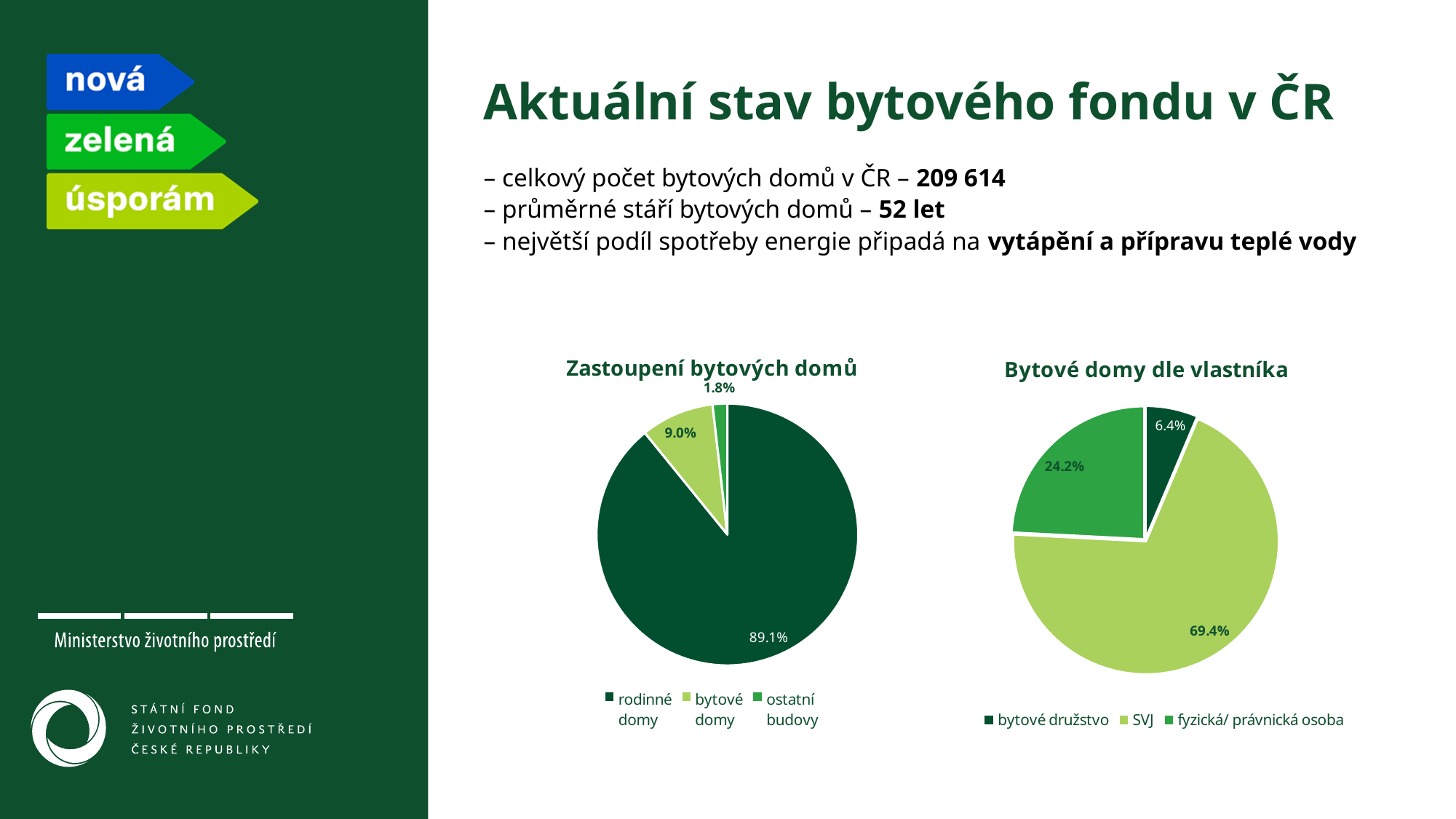
What type of chart is 'Bytové domy dle vlastníka'? pie chart In the 'Bytové domy dle vlastníka' chart, what is the difference between the shares of 'fyzická/ právnická osoba' and 'bytové družstvo'? 17.8% In the 'Zastoupení bytových domů' chart, what share do 'bytové domy' have? 9.0% In the 'Zastoupení bytových domů' chart, how many categories does the legend list? 3 In the 'Zastoupení bytových domů' chart, which category has the smallest slice? ostatní budovy In the 'Zastoupení bytových domů' chart, what share do 'ostatní budovy' have? 1.8% In the 'Bytové domy dle vlastníka' chart, what share does 'fyzická/ právnická osoba' have? 24.2% In the 'Bytové domy dle vlastníka' chart, which category has the largest slice? SVJ In the 'Bytové domy dle vlastníka' chart, what share does 'SVJ' have? 69.4% In the 'Bytové domy dle vlastníka' chart, what share does 'bytové družstvo' have? 6.4% In the 'Zastoupení bytových domů' chart, which category has the largest slice? rodinné domy In the 'Zastoupení bytových domů' chart, what share do 'rodinné domy' have? 89.1%